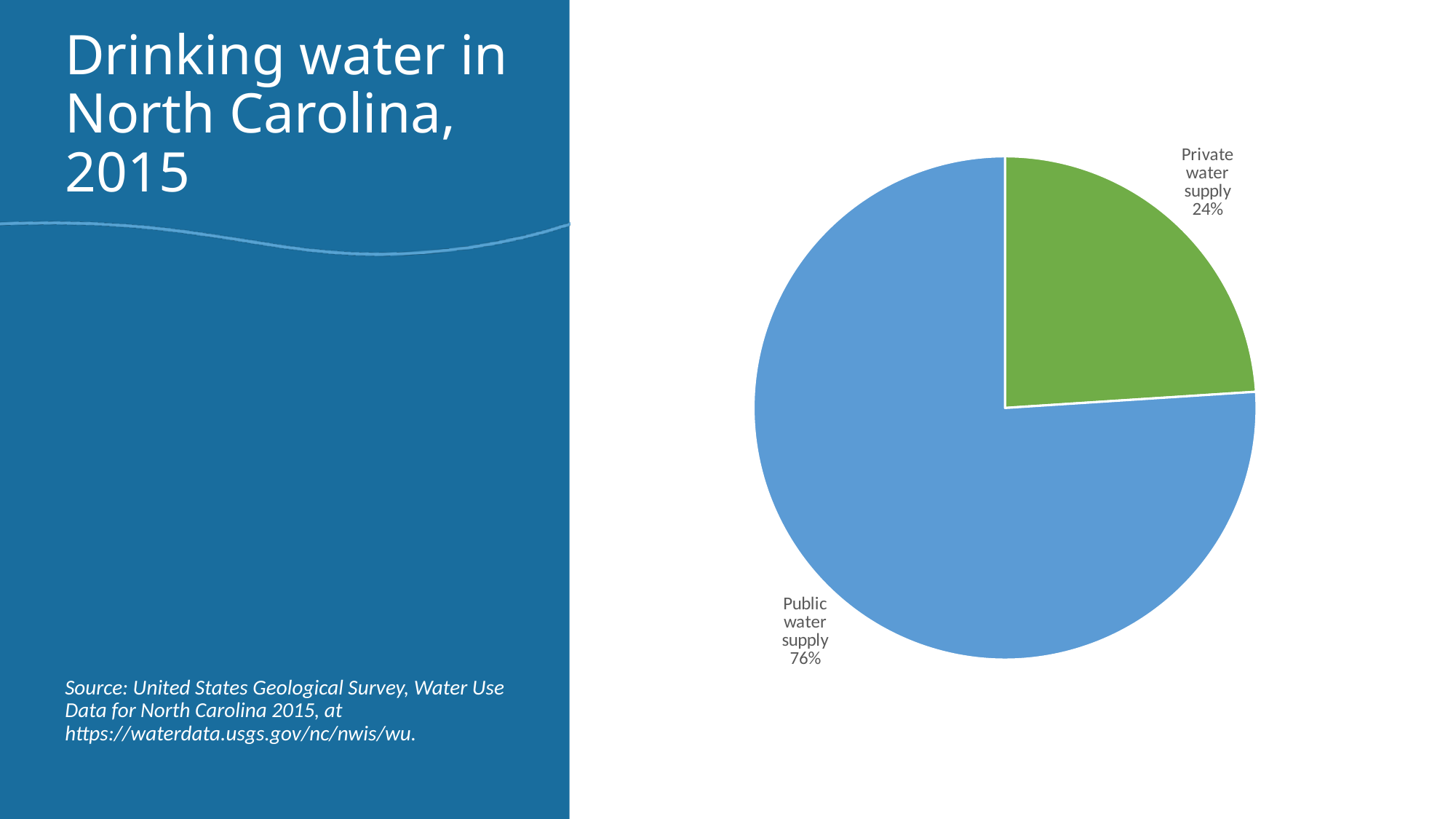
What kind of chart is shown on the slide? Pie chart Which slice of the pie is the smallest? Private water supply What colour is the Public water supply slice? Blue How many slices does the pie chart have? 2 What share of the pie does Public water supply represent? 76% What is the difference in percentage points between Public water supply and Private water supply? 52 What share of the pie does Private water supply represent? 24% What is the total of the two slice percentages shown on the pie chart? 100% Which slice of the pie is the largest? Public water supply What colour is the Private water supply slice? Green Which is larger, the Public water supply slice or the Private water supply slice? Public water supply